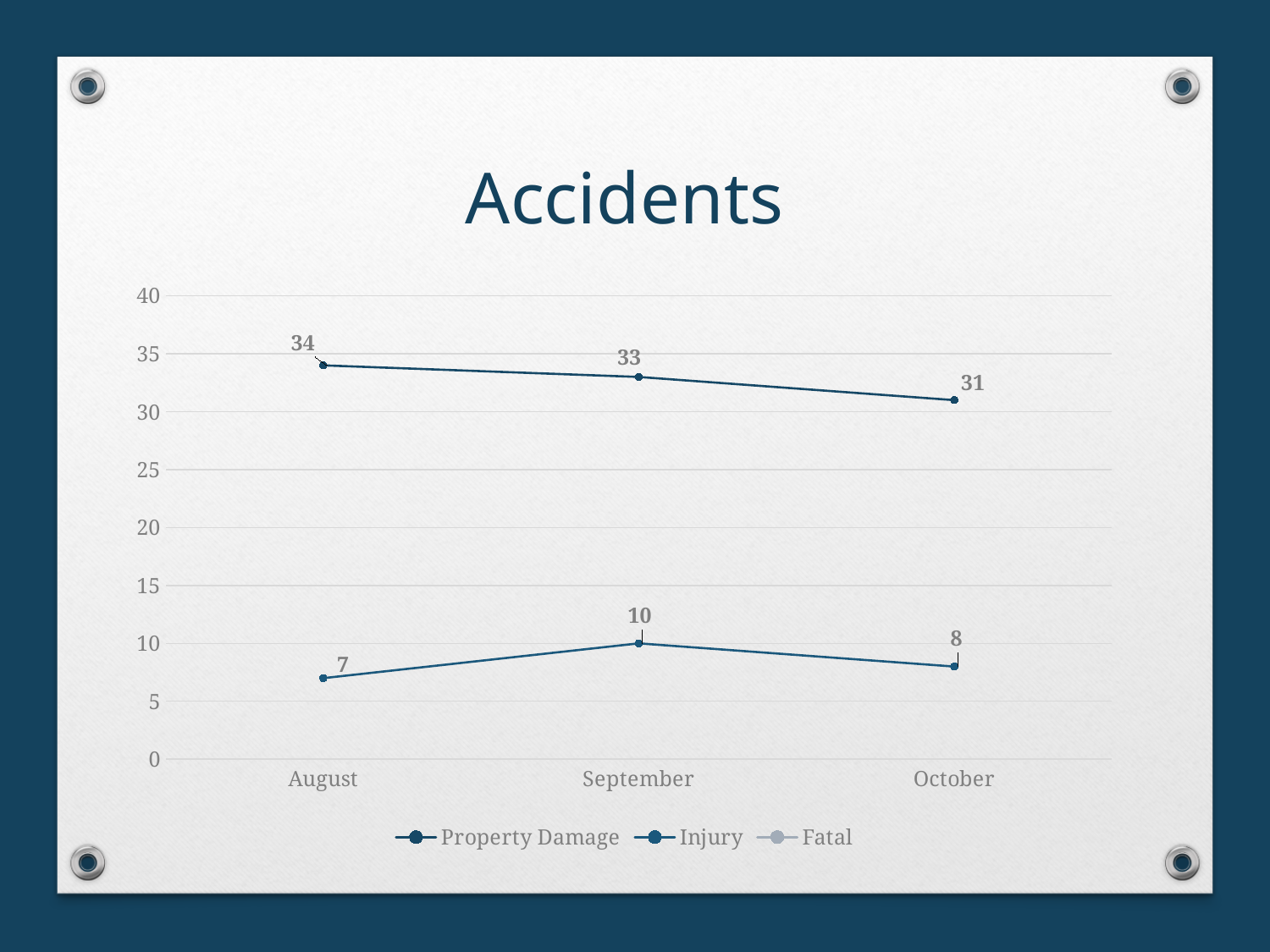
How many months are shown on the x axis? 3 What is the Property Damage value for August? 34 What type of chart is shown on the slide? line chart What is the Property Damage value for October? 31 What is the title of the chart? Accidents How many series does the legend list? 3 In which month is the Injury value highest? September What is the Injury value for September? 10 Which is larger, the Injury value for August or for October? October Does the Property Damage series rise or fall from August to October? fall In which month is the Property Damage value lowest? October What is the difference between the Property Damage values for August and October? 3